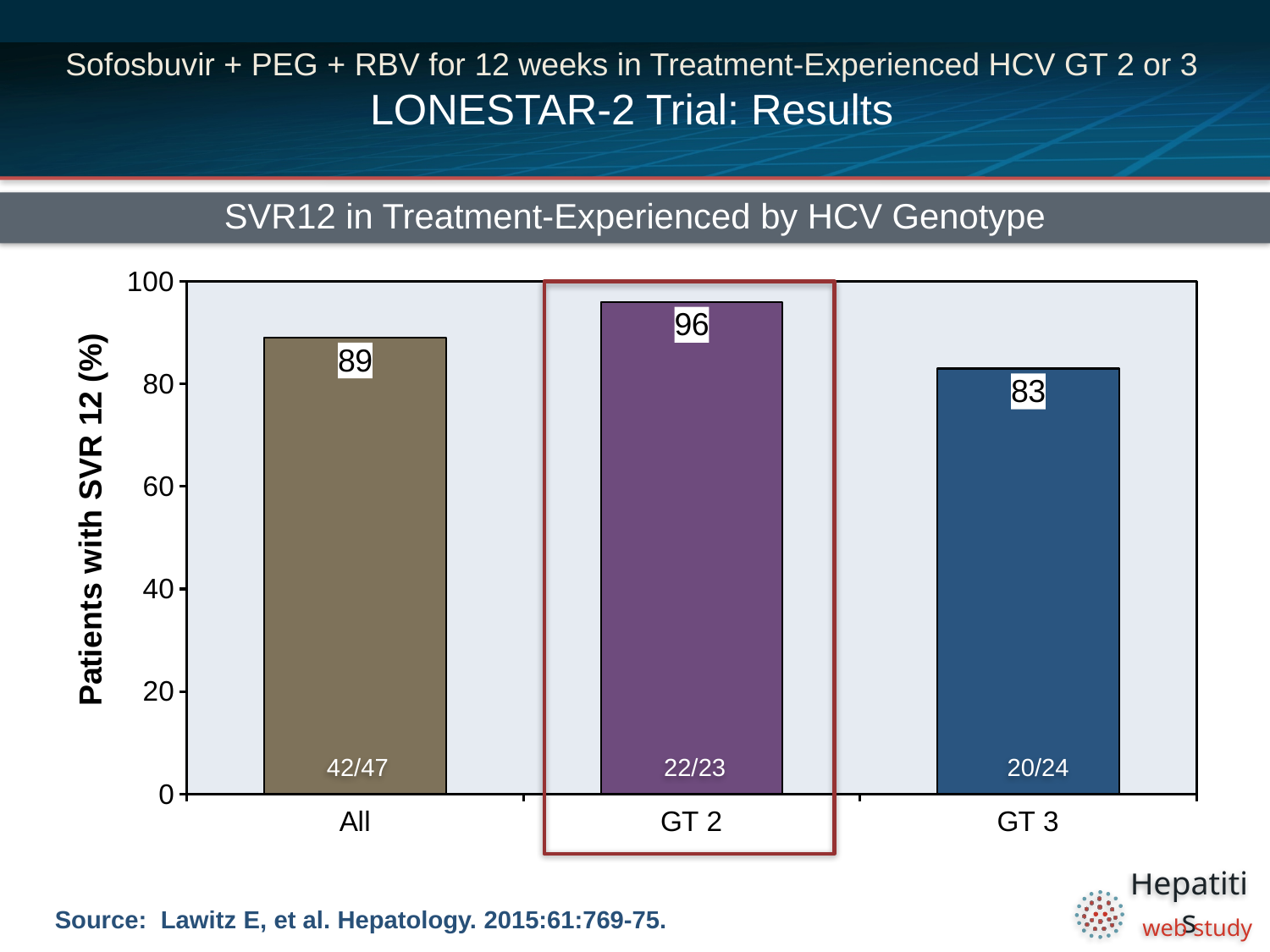
Which genotype group has the highest SVR12 rate? GT 2 What is the SVR12 rate for GT 3? 83 How many categories are shown on the x axis? 3 What fraction of patients is printed on the All bar? 42/47 What is the SVR12 rate for the All group? 89 What is the SVR12 rate for GT 2? 96 Which category has the lowest SVR12 rate? GT 3 What kind of chart is shown on the slide? Bar chart What is the title of the chart? SVR12 in Treatment-Experienced by HCV Genotype Which has a higher SVR12 rate, All or GT 3? All What is the difference in SVR12 rate between GT 2 and GT 3? 13 What fraction of patients is printed on the GT 2 bar? 22/23